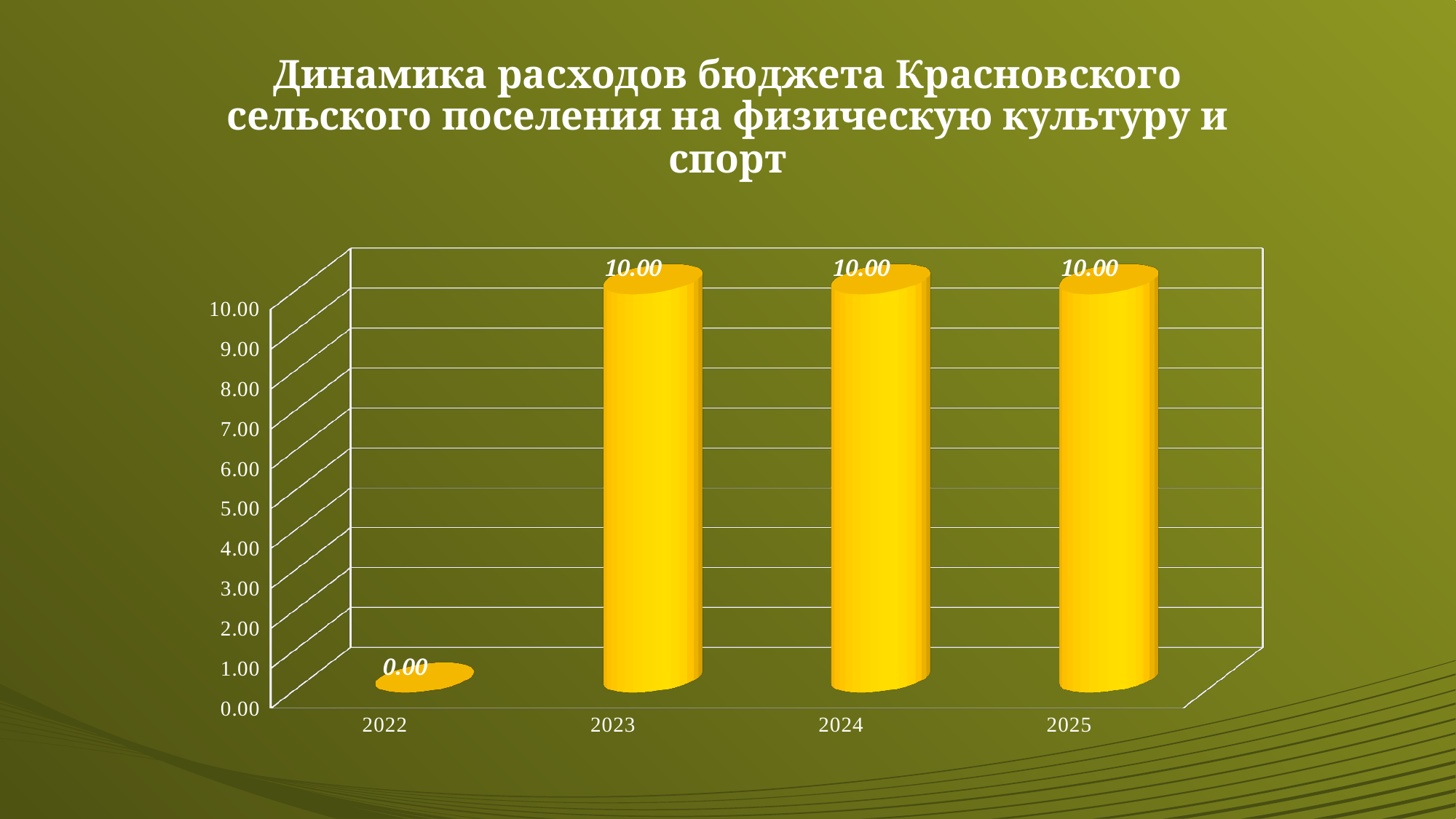
What is the difference between the values for 2023 and 2022? 10.00 Does the value rise or fall from 2022 to 2023? rise What is the value for 2022? 0.00 What kind of chart is shown on the slide? bar chart What is the highest value shown on the vertical axis? 10.00 How many years are shown on the x axis? 4 Which year has the lowest value? 2022 What colour are the bars in the chart? yellow What is the value for 2025? 10.00 Is the value for 2024 greater or less than 5.00? greater What is the value for 2023? 10.00 Which is larger, the value for 2022 or the value for 2024? 2024